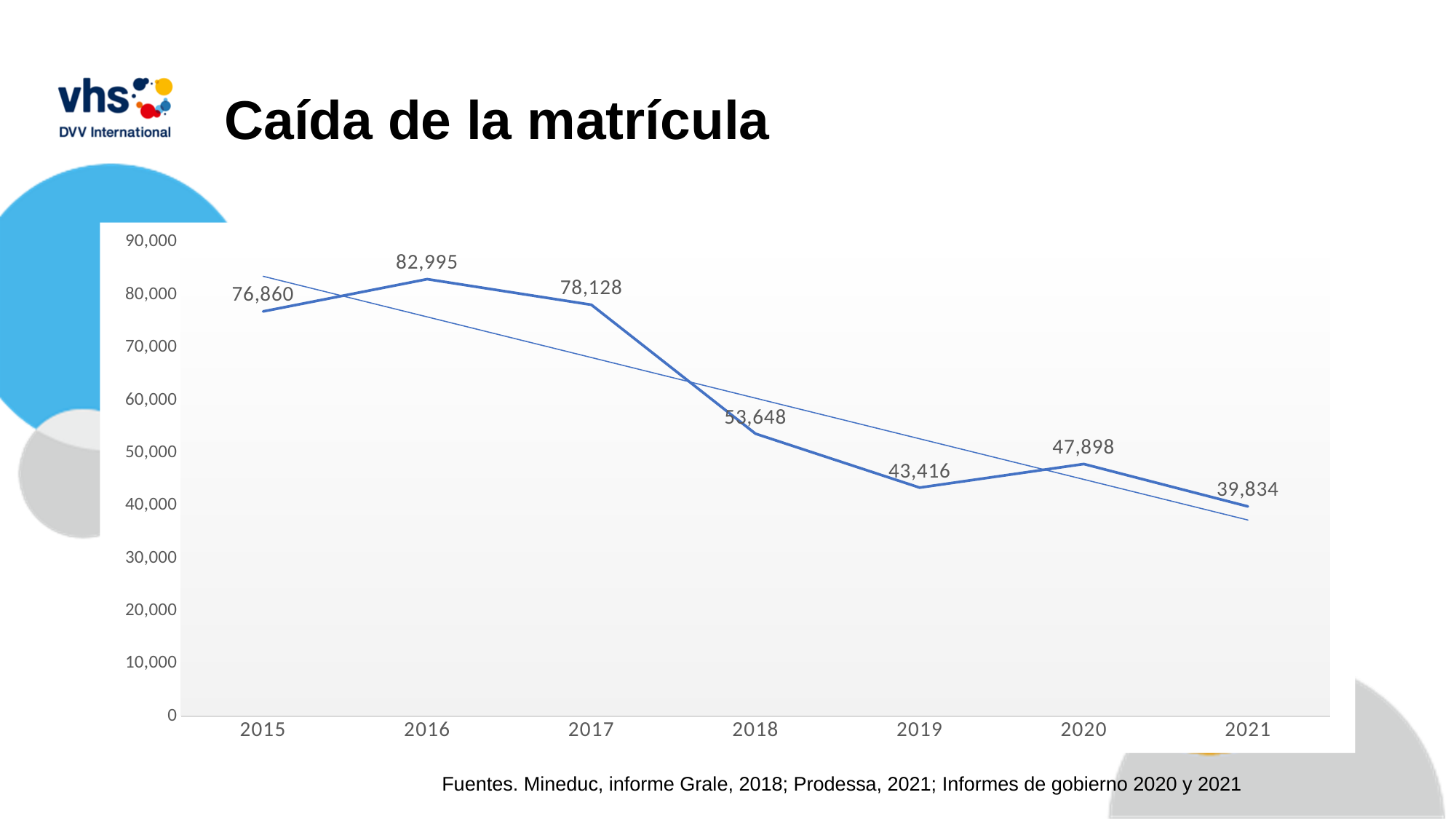
Which is larger, the value for 2019 or the value for 2020? 2020 What is the value for 2021? 39,834 Do the values generally rise or fall from 2015 to 2021? fall How many years are plotted on the x axis? 7 What is the difference between the values for 2016 and 2021? 43,161 What is the title of the slide? Caída de la matrícula What is the value for 2018? 53,648 What is the value for 2016? 82,995 Which year has the lowest value? 2021 What kind of chart is shown? line chart Is the value for 2017 greater or less than 70,000? greater Which year has the highest value? 2016